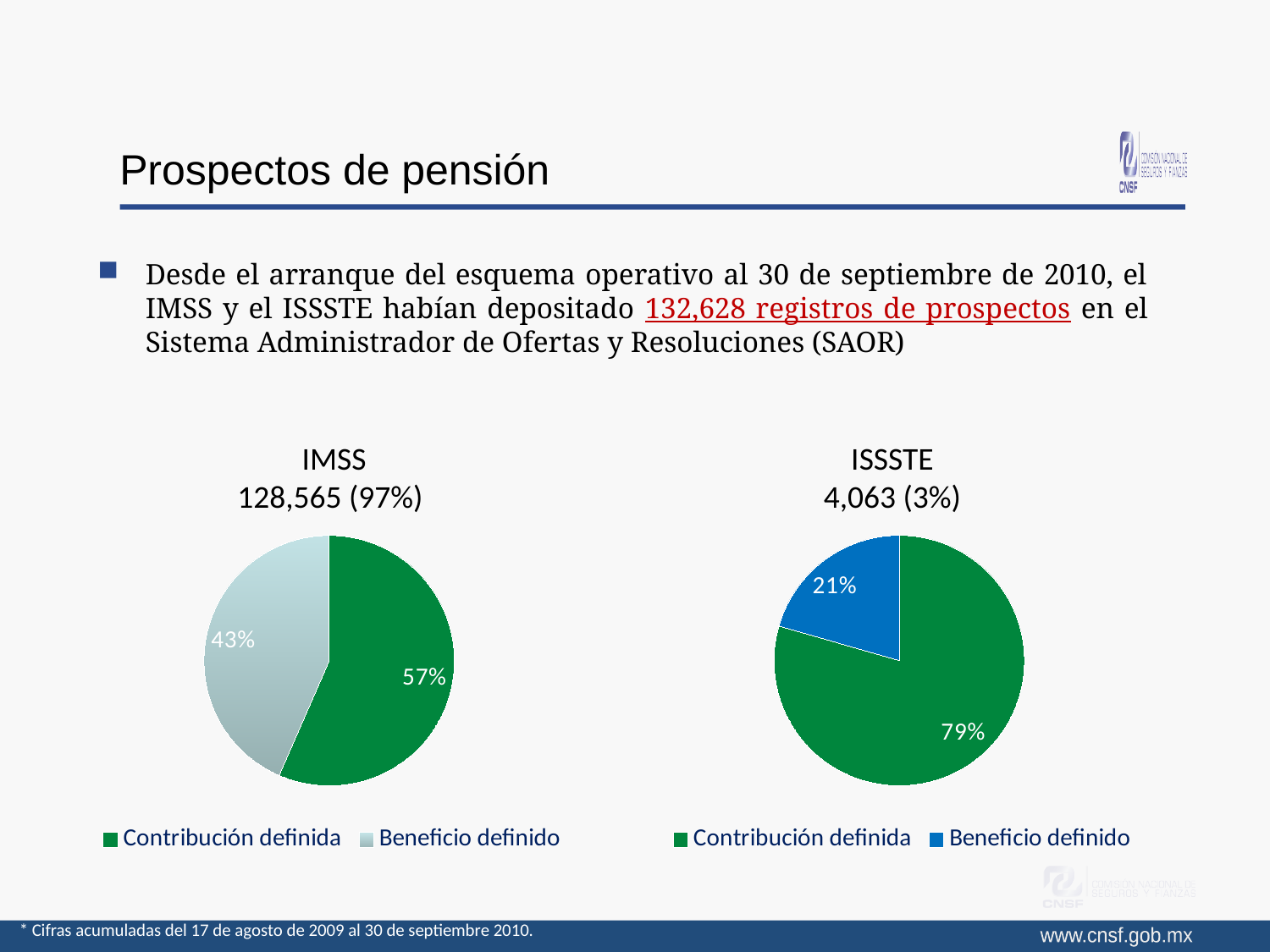
In the IMSS chart, what share of the pie is Beneficio definido? 43% In the ISSSTE chart, what share of the pie is Beneficio definido? 21% In the IMSS chart, what is the difference in percentage points between Contribución definida and Beneficio definido? 14 In the ISSSTE chart, what is the difference in percentage points between Contribución definida and Beneficio definido? 58 How many slices does the ISSSTE pie chart have? 2 What kind of chart is the IMSS chart? Pie chart What total number of records is shown in the title of the IMSS chart? 128,565 (97%) In the IMSS chart, which slice is the largest? Contribución definida In the IMSS chart, what share of the pie is Contribución definida? 57% In the ISSSTE chart, which slice is the smallest? Beneficio definido Which chart has the larger share for Contribución definida, IMSS or ISSSTE? ISSSTE